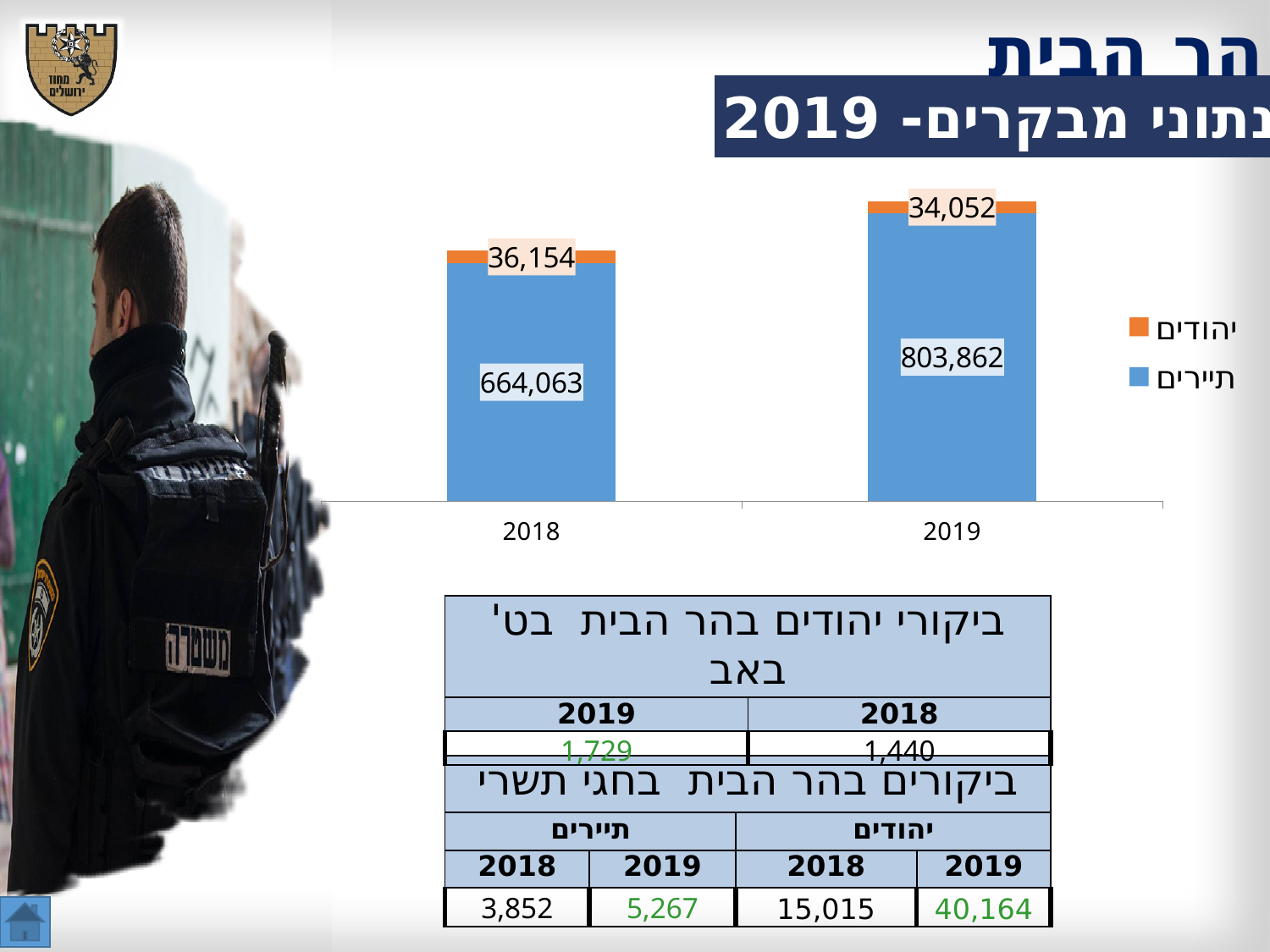
How many series does the legend list? 2 What is the value for תיירים in 2019? 803,862 What kind of chart is shown on the slide? Stacked bar chart What is the difference between the יהודים values for 2018 and 2019? 2,102 What is the total of the stacked bar for 2019? 837,914 Which year has the lower value for יהודים? 2019 What is the value for יהודים in 2019? 34,052 What is the value for תיירים in 2018? 664,063 What is the value for יהודים in 2018? 36,154 Which year has the higher value for תיירים? 2019 What is the total of the stacked bar for 2018? 700,217 What is the difference between the תיירים values for 2019 and 2018? 139,799